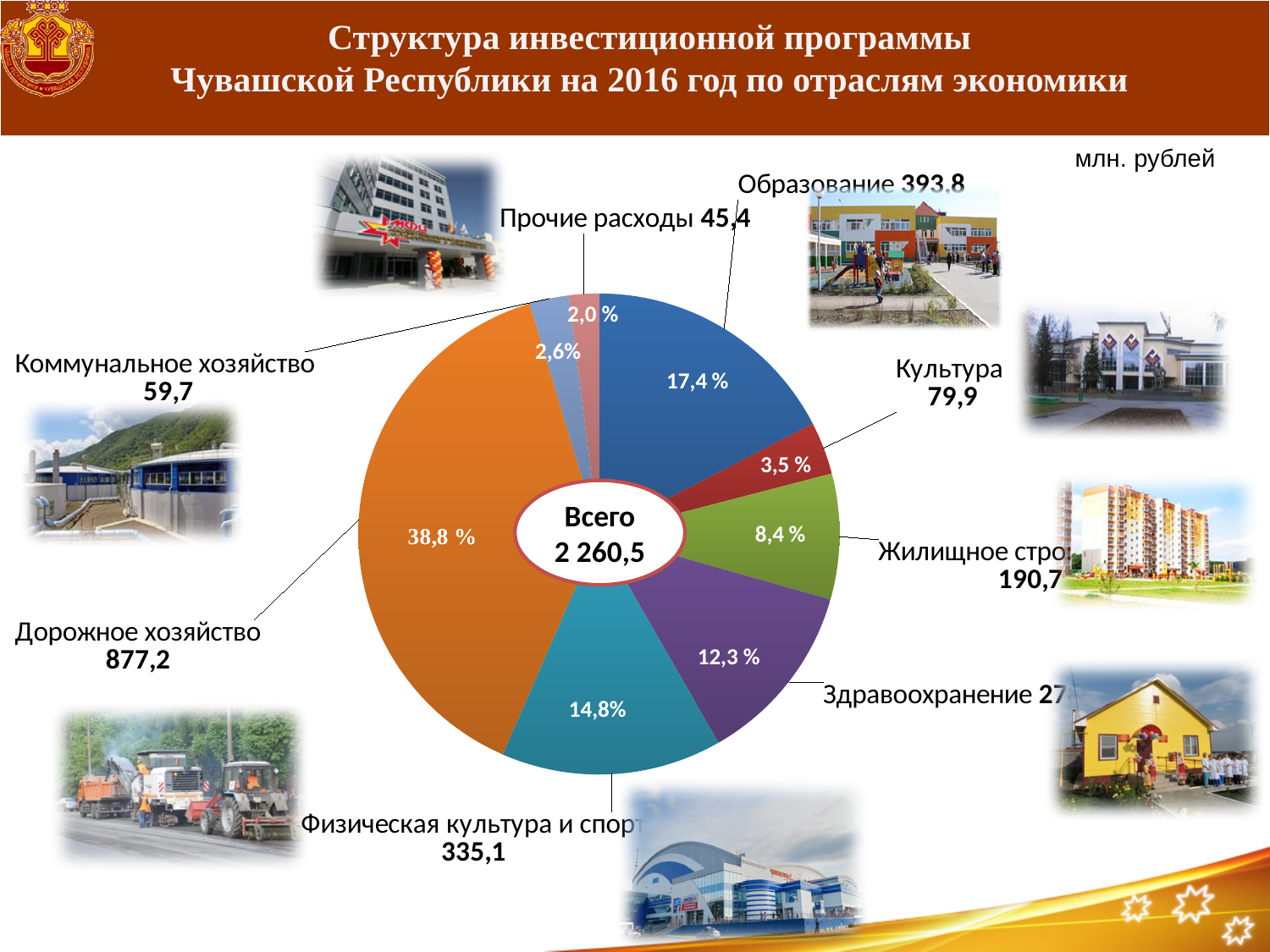
What is the value for Образование? 393,8 What kind of chart is shown on the slide? pie chart What is the value for Коммунальное хозяйство? 59,7 What is the value for Дорожное хозяйство? 877,2 Which category has the smallest slice of the pie? Прочие расходы What is the value for Физическая культура и спорт? 335,1 What share of the pie does Дорожное хозяйство take? 38,8 % Which is larger, the value for Образование or the value for Культура? Образование Which category has the largest slice of the pie? Дорожное хозяйство What is the total value shown in the centre of the pie chart (Всего)? 2 260,5 What share of the pie does Образование take? 17,4 % What is the difference between the values for Дорожное хозяйство and Физическая культура и спорт? 542,1